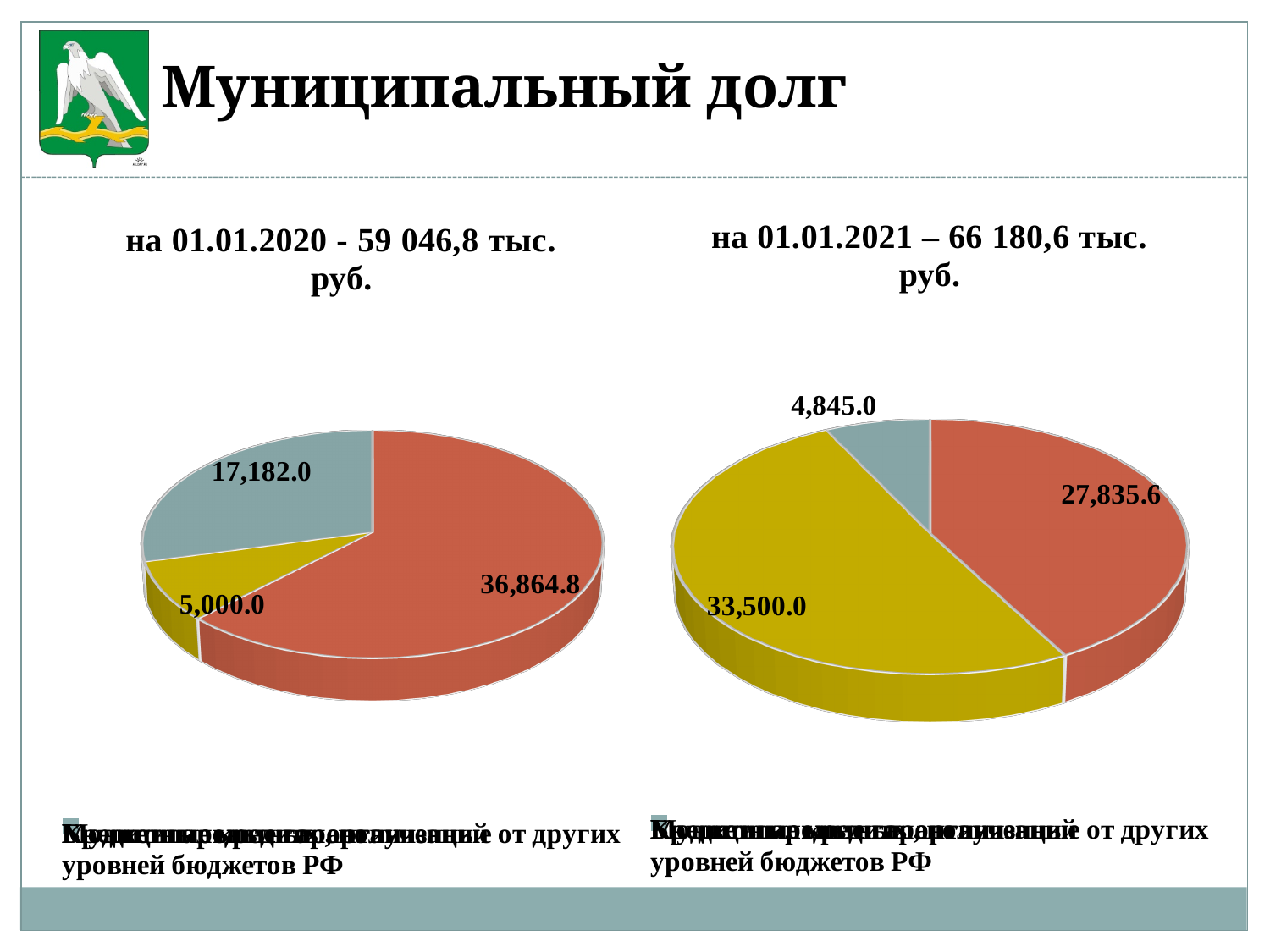
In the left pie chart (на 01.01.2020), which slice has the largest value? the red slice (36,864.8) In the right pie chart (на 01.01.2021), which slice has the smallest value? the grey-blue slice (4,845.0) Is the red slice larger in the left pie chart (на 01.01.2020) or in the right pie chart (на 01.01.2021)? the left pie chart (36,864.8) In the right pie chart (на 01.01.2021), what is the difference between the yellow slice and the red slice? 5,664.4 In the left pie chart (на 01.01.2020), what value is shown for the yellow slice? 5,000.0 In the right pie chart (на 01.01.2021), what value is shown for the yellow slice? 33,500.0 What type of chart is used on this slide? pie chart In the right pie chart (на 01.01.2021), what value is shown for the grey-blue slice? 4,845.0 How many slices does the right pie chart (на 01.01.2021) have? 3 In the left pie chart (на 01.01.2020), what value is shown for the red slice? 36,864.8 What total municipal debt is stated in the title of the right chart (на 01.01.2021)? 66 180,6 тыс. руб. In the left pie chart (на 01.01.2020), what is the difference between the red slice and the grey-blue slice? 19,682.8